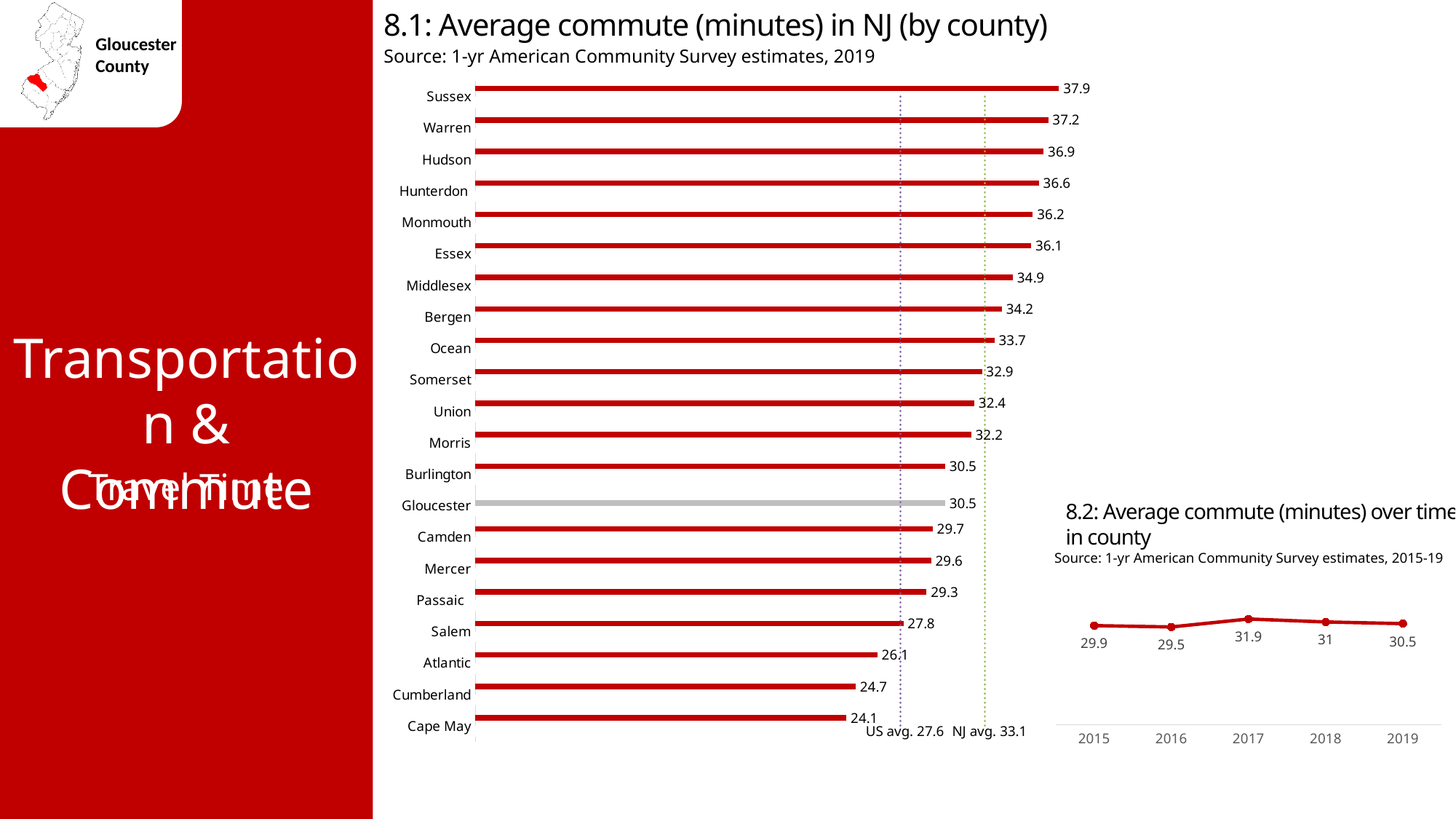
In chart 8.1 (Average commute in NJ by county), what is the difference between the average commute for Sussex and Cape May? 13.8 In chart 8.1 (Average commute in NJ by county), which has a longer average commute, Camden or Salem? Camden In chart 8.1 (Average commute in NJ by county), what is the average commute for Hudson? 36.9 In chart 8.1 (Average commute in NJ by county), what NJ average is marked by the dotted reference line? 33.1 What kind of chart is chart 8.2 (Average commute over time in county)? line chart In chart 8.2 (Average commute over time in county), what is the difference between the 2019 and 2015 values? 0.6 In chart 8.1 (Average commute in NJ by county), which county has the highest average commute? Sussex In chart 8.1 (Average commute in NJ by county), which county has the lowest average commute? Cape May In chart 8.1 (Average commute in NJ by county), how many counties are shown? 21 In chart 8.2 (Average commute over time in county), what was the average commute in 2017? 31.9 In chart 8.2 (Average commute over time in county), which year had the highest average commute? 2017 In chart 8.1 (Average commute in NJ by county), what is the average commute for Gloucester? 30.5